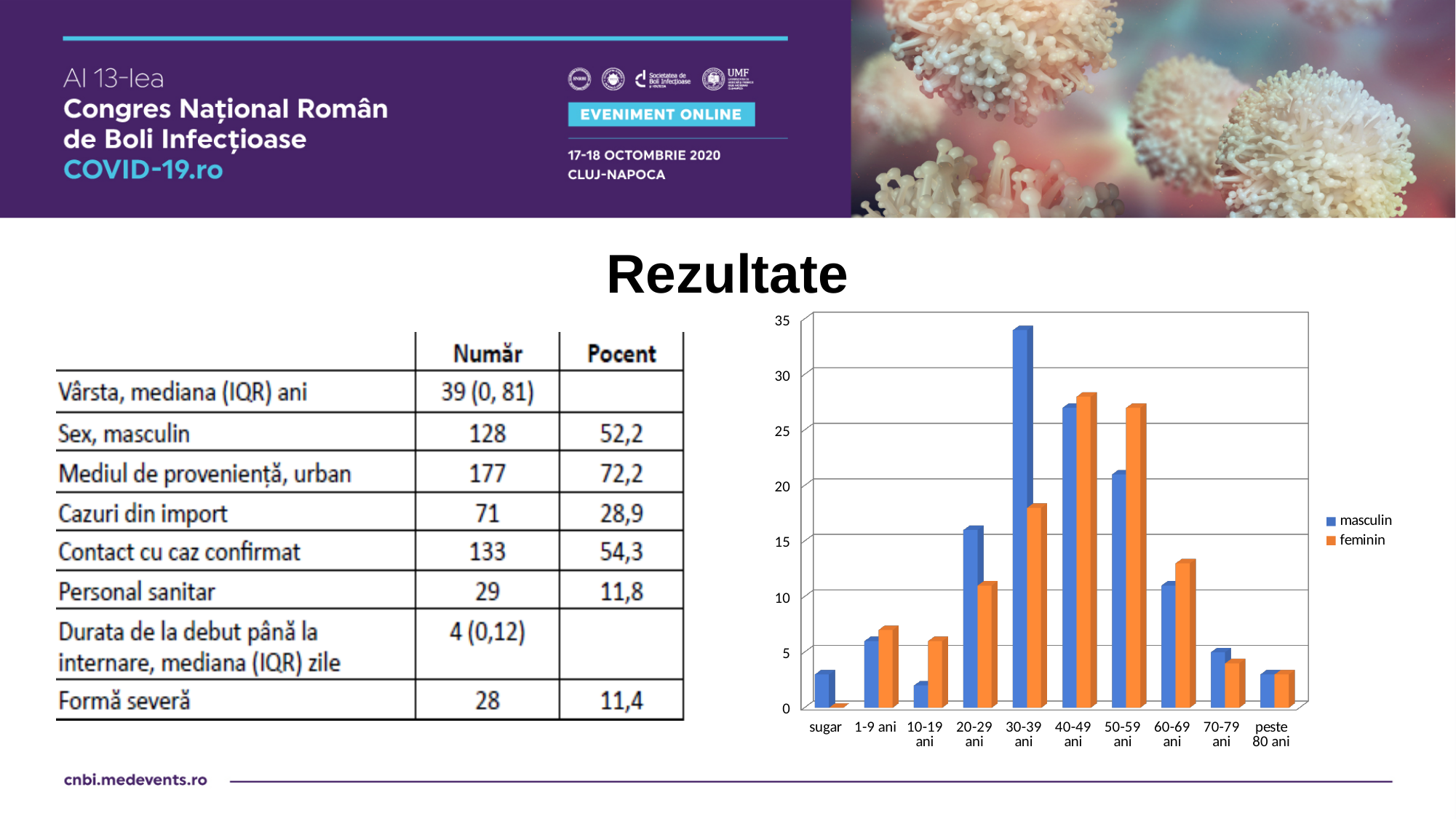
How many age categories are shown on the x axis of the bar chart? 10 For the 60-69 ani category, which series has the larger value, masculin or feminin? feminin Is the masculin value for 20-29 ani greater or less than 10? greater Is the masculin value for 30-39 ani greater or less than 30? greater How many series does the legend of the bar chart list? 2 Which age category has the highest value for the masculin series? 30-39 ani Is the feminin value for 30-39 ani greater or less than 20? less What are the two legend entries of the bar chart? masculin, feminin For the 30-39 ani category, which series has the larger value, masculin or feminin? masculin What kind of chart is shown on the right side of the slide? bar chart Which age category has the lowest value for the feminin series? sugar